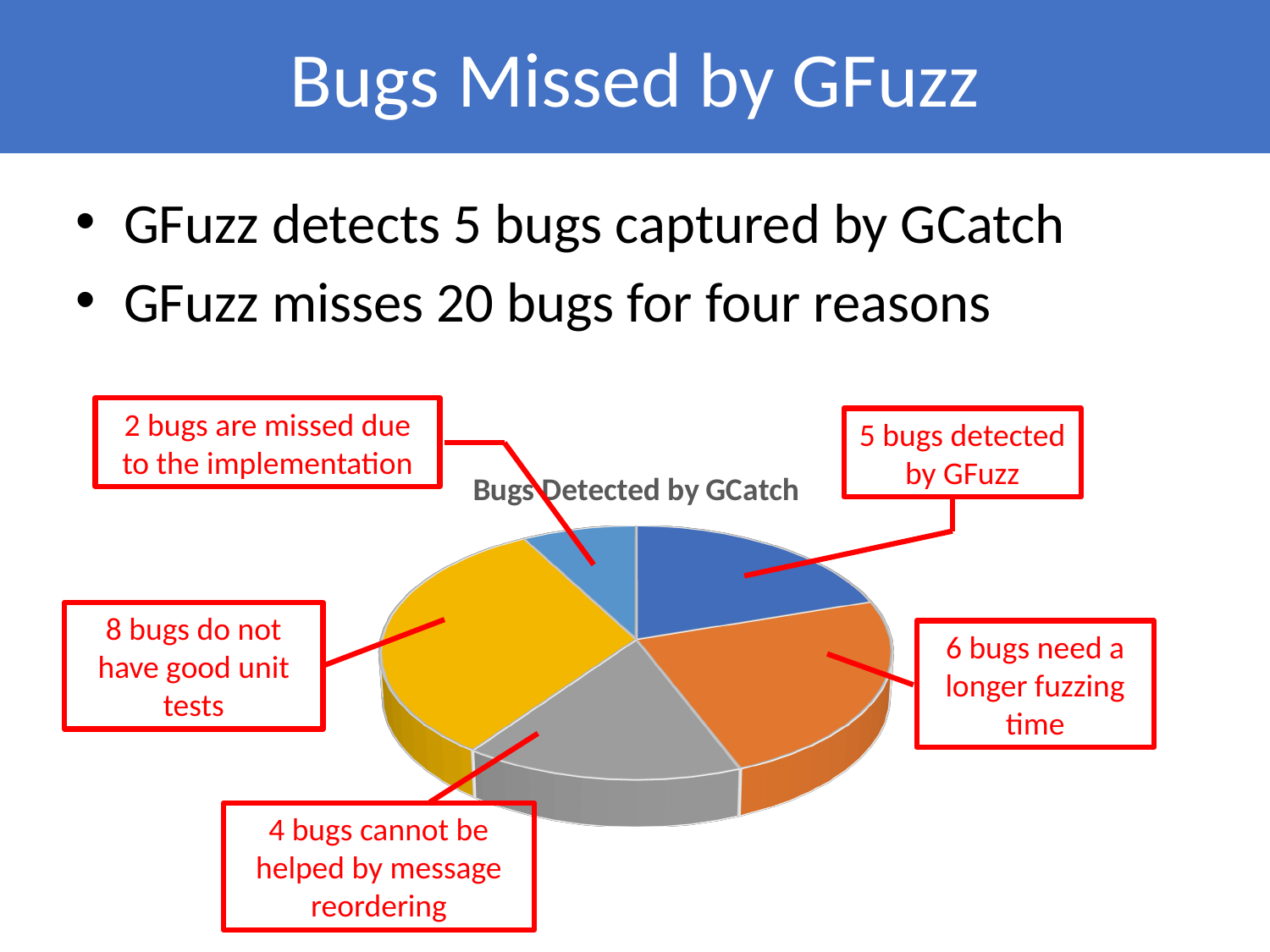
Which category accounts for the smallest slice of the pie? 2 bugs are missed due to the implementation What is the total number of bugs represented in the pie chart? 25 Which is larger: the number of bugs needing a longer fuzzing time or the number of bugs detected by GFuzz? bugs needing a longer fuzzing time How many bugs do not have good unit tests? 8 How many bugs are detected by GFuzz according to the chart callout? 5 How many slices does the pie chart have? 5 How many bugs are missed due to the implementation? 2 How many bugs need a longer fuzzing time? 6 What is the difference between the number of bugs lacking good unit tests and the number of bugs that cannot be helped by message reordering? 4 Which category accounts for the largest slice of the pie? 8 bugs do not have good unit tests What kind of chart is shown on the slide? pie chart What is the title of the pie chart? Bugs Detected by GCatch